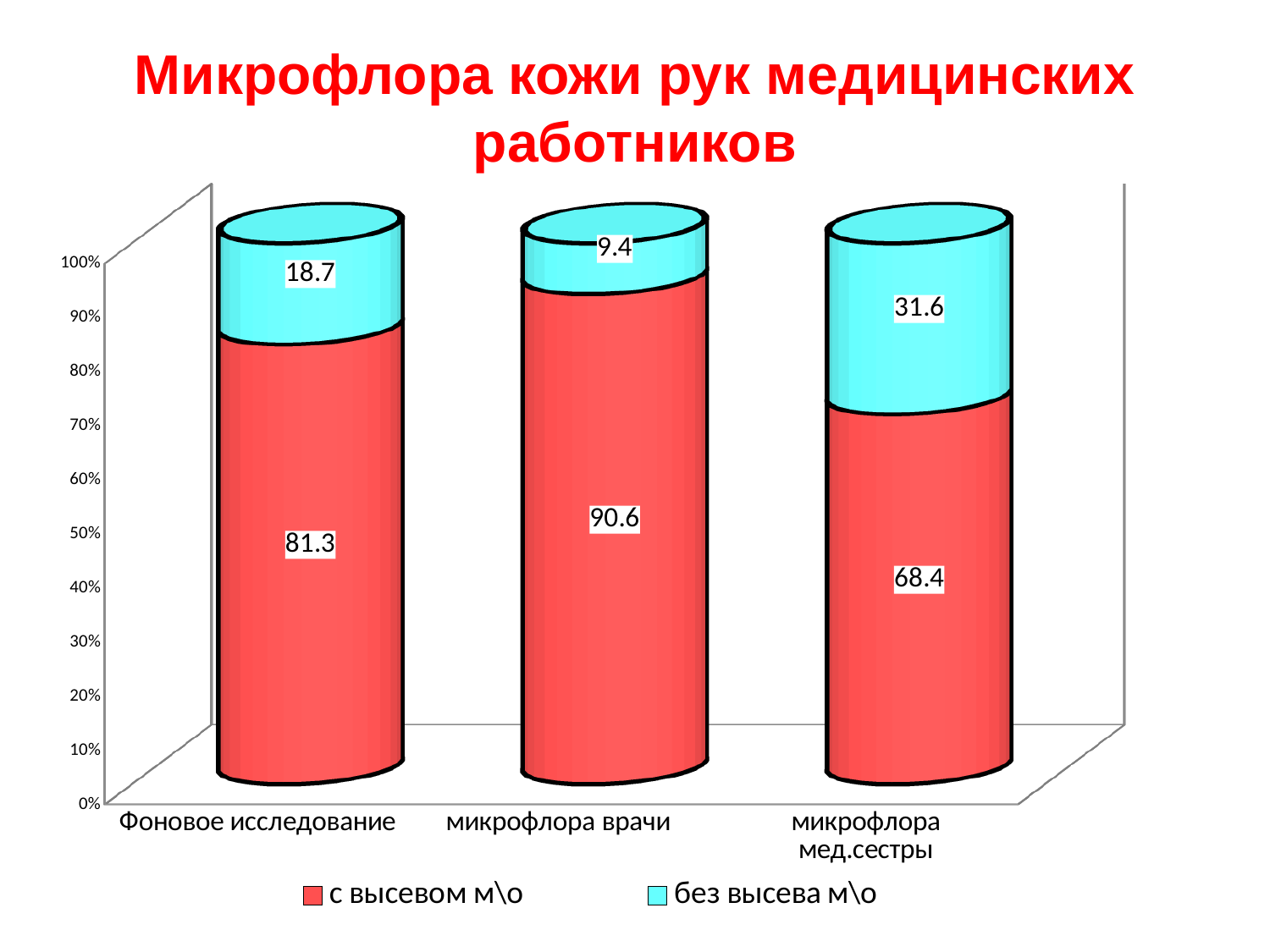
What is the title of the chart? Микрофлора кожи рук медицинских работников What kind of chart is shown on the slide? stacked bar chart What is the value of 'с высевом м\о' for 'микрофлора врачи'? 90.6 Which is larger: the 'без высева м\о' value for 'Фоновое исследование' or for 'микрофлора мед.сестры'? микрофлора мед.сестры Which category has the highest value for 'с высевом м\о'? микрофлора врачи What is the total of the stacked bar for 'Фоновое исследование'? 100 What is the difference between the 'с высевом м\о' values for 'микрофлора врачи' and 'микрофлора мед.сестры'? 22.2 How many categories are shown on the x axis? 3 What is the value of 'без высева м\о' for 'микрофлора мед.сестры'? 31.6 What is the value of 'без высева м\о' for 'Фоновое исследование'? 18.7 How many series does the legend list? 2 Which category has the lowest value for 'без высева м\о'? микрофлора врачи